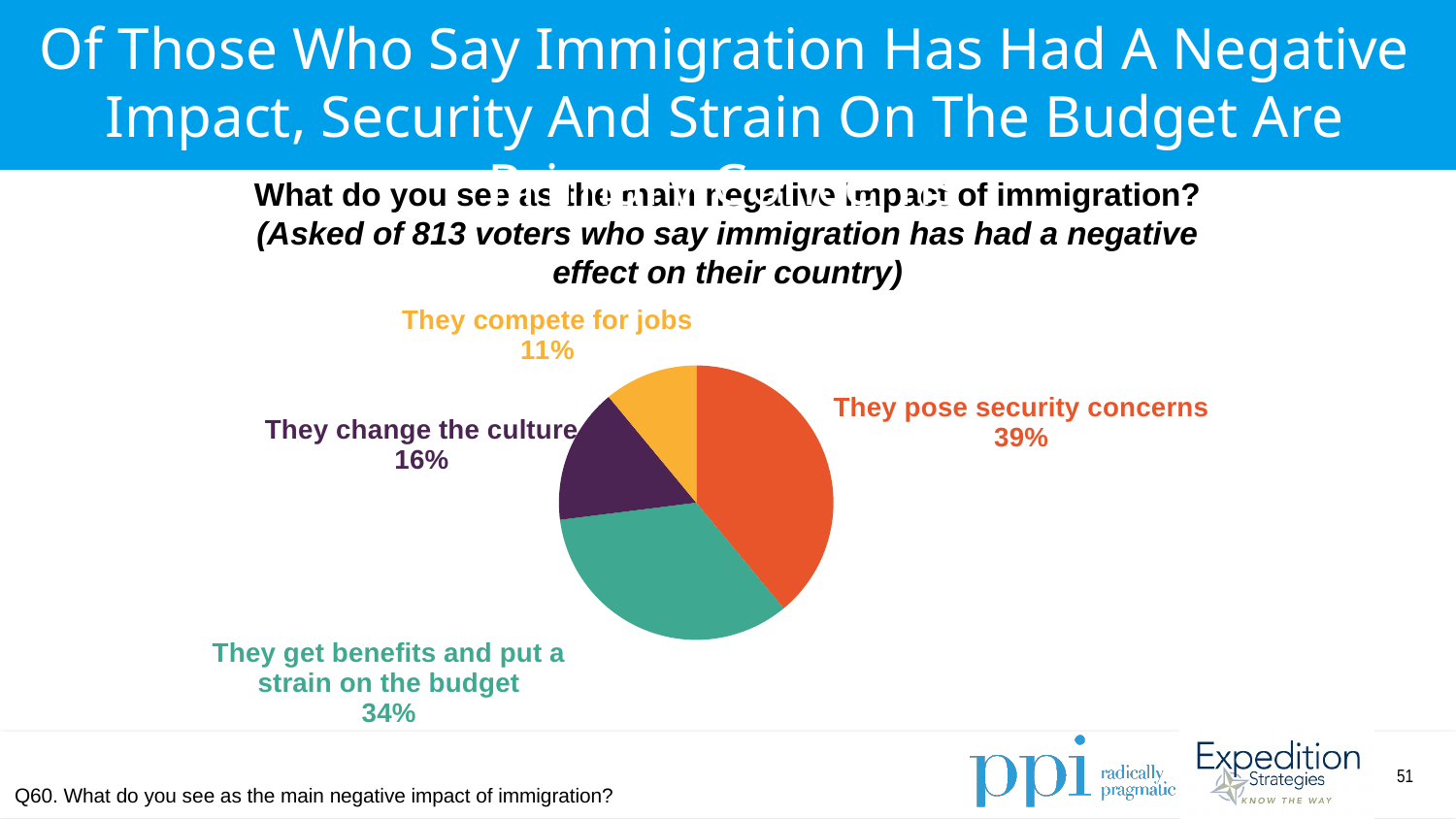
What percentage of respondents say immigrants get benefits and put a strain on the budget? 34% What is the difference in percentage points between 'They pose security concerns' and 'They get benefits and put a strain on the budget'? 5 Which negative impact has the largest share of the pie? They pose security concerns How many categories are shown in the pie chart? 4 What percentage of respondents say immigrants compete for jobs? 11% Which is larger: the share for 'They change the culture' or the share for 'They compete for jobs'? They change the culture Which negative impact has the smallest share of the pie? They compete for jobs How many voters were asked the question shown above the chart? 813 What kind of chart is shown on the slide? Pie chart What is the difference in percentage points between 'They change the culture' and 'They compete for jobs'? 5 What percentage of respondents say immigrants pose security concerns? 39% What percentage of respondents say immigrants change the culture? 16%